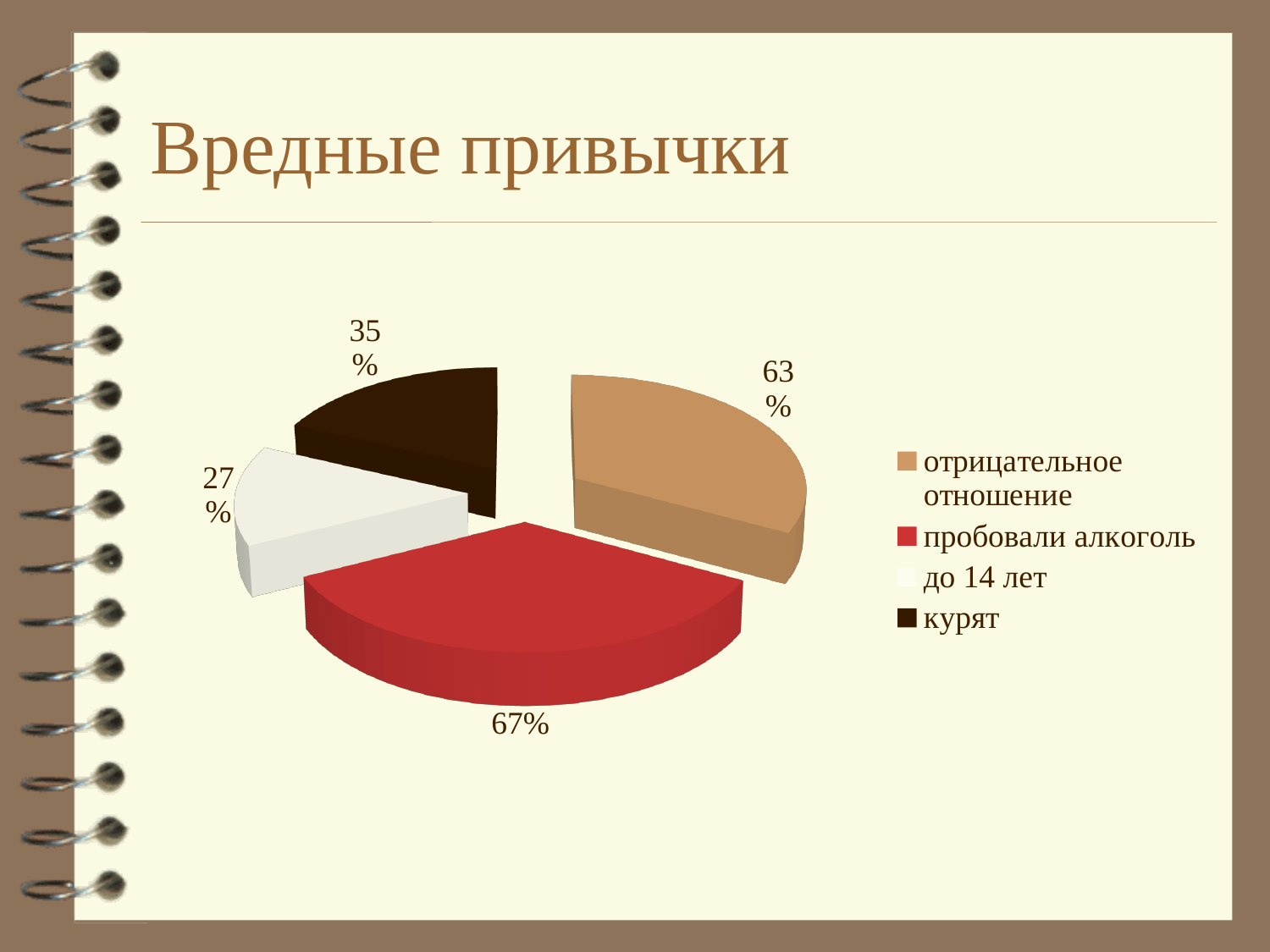
What is the difference between the values for "пробовали алкоголь" and "курят"? 32% What is the title of the slide containing the chart? Вредные привычки What is the value shown for the slice "отрицательное отношение"? 63% How many slices does the pie chart have? 4 What kind of chart is shown on the slide? pie chart What is the difference between the values for "курят" and "до 14 лет"? 8% What is the value shown for the slice "курят"? 35% What is the value shown for the slice "до 14 лет"? 27% Which is larger, the value for "отрицательное отношение" or the value for "курят"? отрицательное отношение Which slice has the highest value? пробовали алкоголь What is the value shown for the slice "пробовали алкоголь"? 67% Which slice has the lowest value? до 14 лет